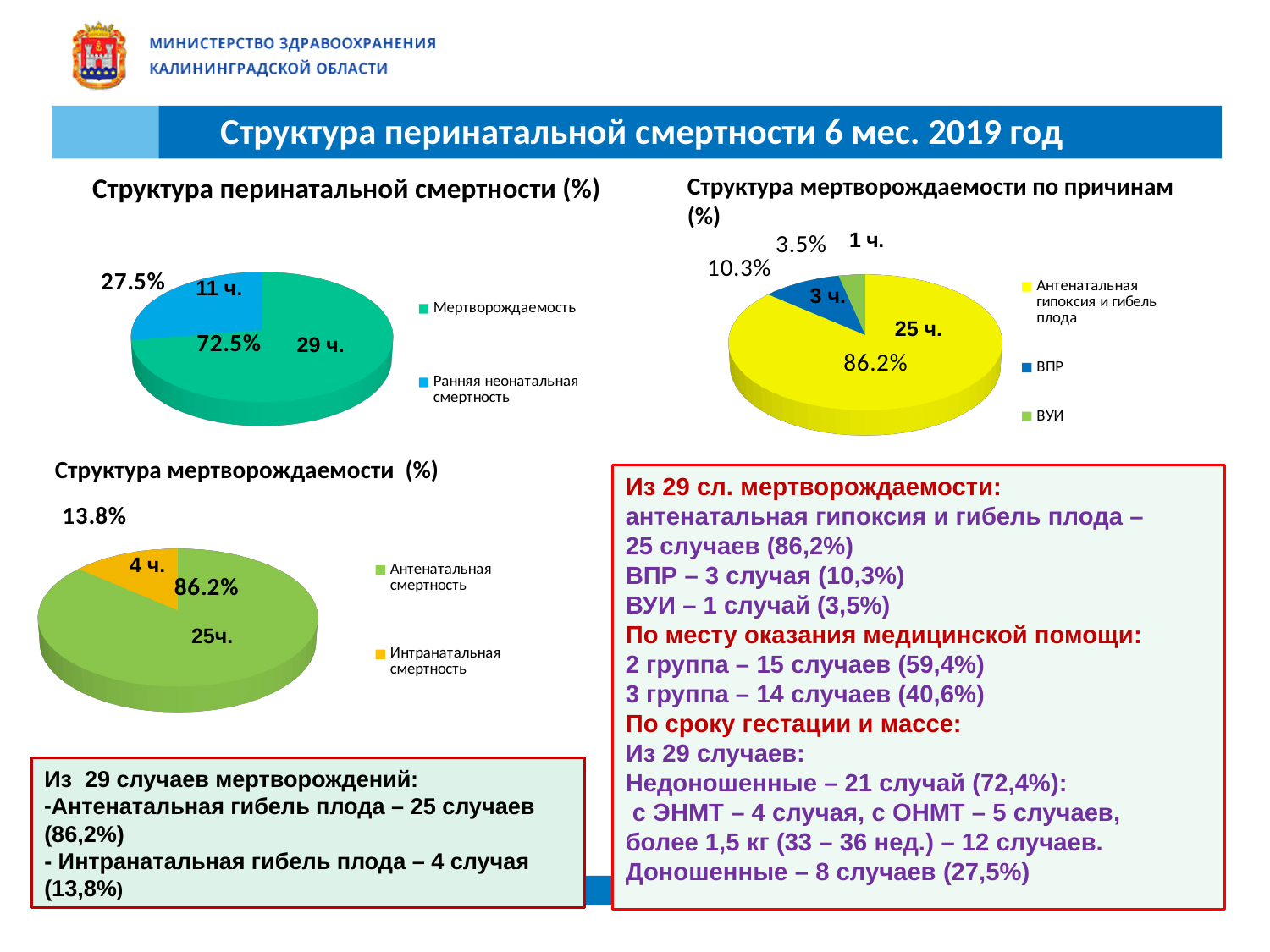
On the chart 'Структура мертворождаемости (%)' at the bottom left, how many cases are shown for Антенатальная смертность? 25ч. On the chart 'Структура мертворождаемости по причинам (%)', what colour is the slice for Антенатальная гипоксия и гибель плода? Yellow What type of chart is 'Структура мертворождаемости (%)' at the bottom left of the slide? Pie chart On the chart 'Структура мертворождаемости по причинам (%)', which category has the smallest share? ВУИ On the chart 'Структура мертворождаемости по причинам (%)', what percentage is shown for ВПР? 10.3% On the chart 'Структура мертворождаемости по причинам (%)', how many cases (ч.) are shown for Антенатальная гипоксия и гибель плода? 25 ч. On the chart 'Структура мертворождаемости (%)' at the bottom left, what percentage is shown for Интранатальная смертность? 13.8% On the chart 'Структура перинатальной смертности (%)', which category has the larger share? Мертворождаемость On the chart 'Структура перинатальной смертности (%)', how many cases (ч.) are shown for Ранняя неонатальная смертность? 11 ч. On the chart 'Структура перинатальной смертности (%)', what is the difference in percentage points between Мертворождаемость and Ранняя неонатальная смертность? 45 percentage points How many categories does the legend of the chart 'Структура мертворождаемости по причинам (%)' list? 3 On the chart 'Структура перинатальной смертности (%)', what percentage is shown for Мертворождаемость? 72.5%